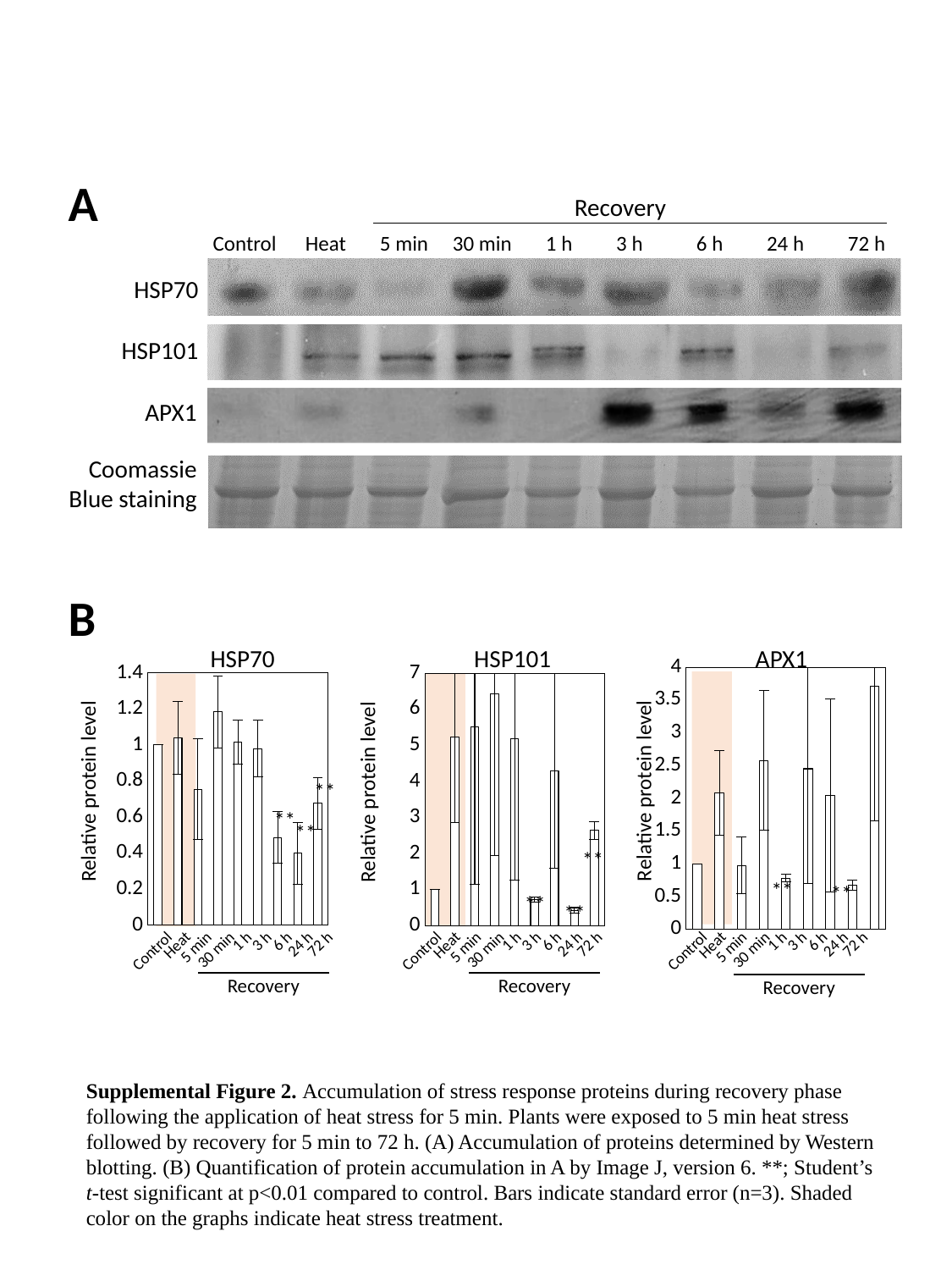
In the HSP70 chart, what kind of chart is used to show the data? bar chart In the HSP70 chart, which category has the highest relative protein level? 30 min What is the y-axis label shared by the three charts in panel B? Relative protein level In the HSP101 chart, is the value for 72 h greater or less than 3? less In the APX1 chart, is the value for 1 h greater or less than 1? less In the HSP101 chart, is the value for 30 min greater or less than 6? greater In the APX1 chart, which category has the highest relative protein level? 72 h In the HSP70 chart, how many categories are shown on the x axis? 9 In the HSP70 chart, what is the relative protein level for Control? 1 In the HSP70 chart, which is larger, the value for 30 min or the value for 24 h? 30 min In the HSP101 chart, which category has the highest relative protein level? 30 min